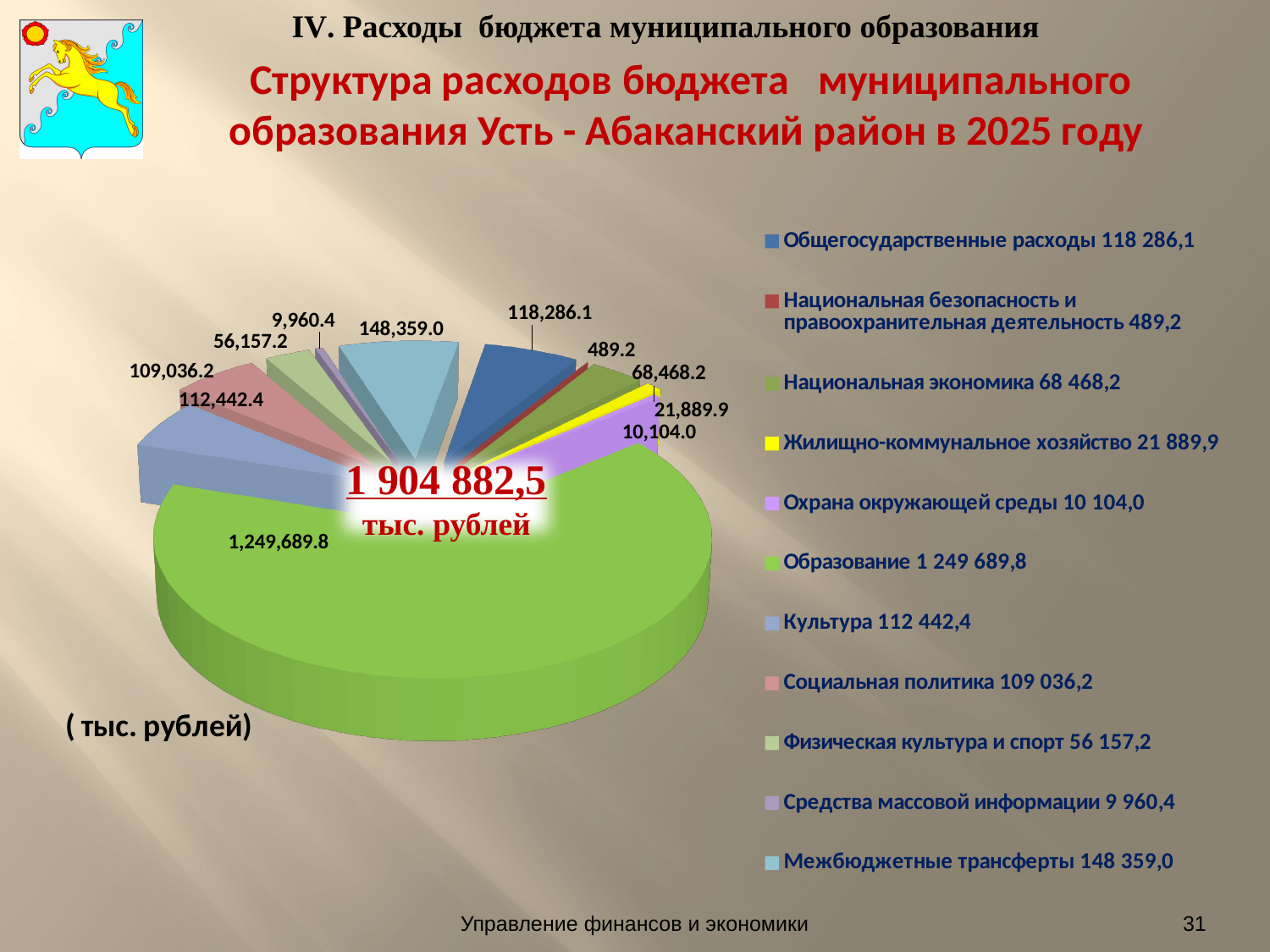
What is the value for Жилищно-коммунальное хозяйство on the pie chart? 21,889.9 What share of the total 1 904 882,5 does Образование (1,249,689.8) represent, to one decimal place? 65.6% Which category has the largest slice of the pie chart? Образование What is the value for Образование on the pie chart? 1,249,689.8 How many slices (categories) does the pie chart have? 11 Which is larger on the pie chart: Культура or Социальная политика? Культура What is the value for Межбюджетные трансферты on the pie chart? 148,359.0 What is the difference between the values for Межбюджетные трансферты and Социальная политика? 39,322.8 What is the difference between the values for Общегосударственные расходы and Культура? 5,843.7 What kind of chart is shown on the slide? pie chart Which category has the smallest slice of the pie chart? Национальная безопасность и правоохранительная деятельность What total amount is printed in the centre of the pie chart? 1 904 882,5 тыс. рублей